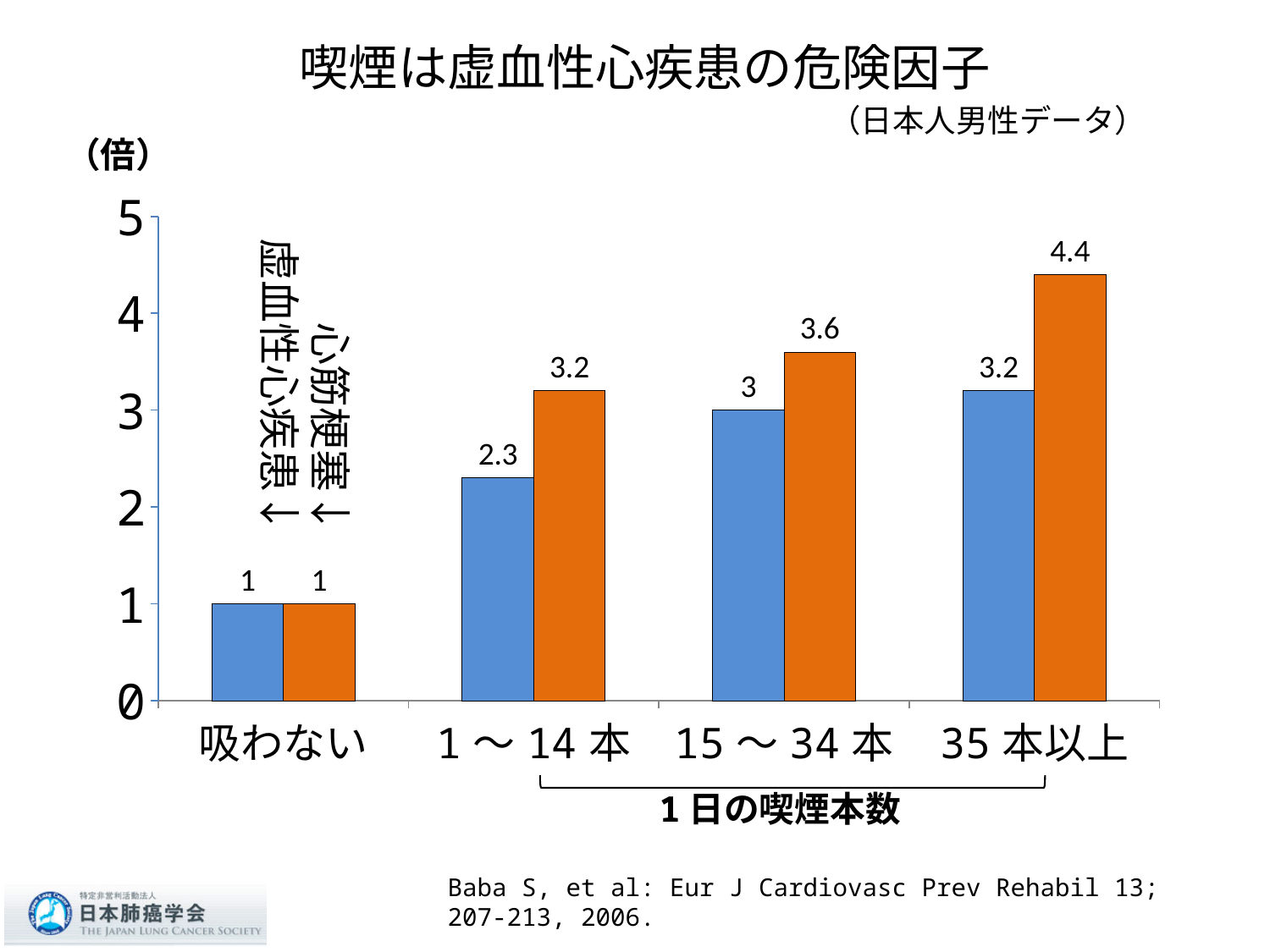
Which is larger in the 15～34本 category: 虚血性心疾患 or 心筋梗塞? 心筋梗塞 What is the value for 心筋梗塞 in the 15～34本 category? 3.6 Which category has the lowest value for 虚血性心疾患? 吸わない What is the value for 心筋梗塞 in the 35本以上 category? 4.4 What is the difference between the 心筋梗塞 and 虚血性心疾患 values in the 35本以上 category? 1.2 Which category has the highest value for 心筋梗塞? 35本以上 What kind of chart is shown on the slide? bar chart How many smoking categories are shown on the x axis? 4 Do the 虚血性心疾患 values rise or fall as the number of cigarettes per day increases? rise What unit is shown at the top of the y axis? （倍） How many data series are plotted in the chart? 2 What is the value for 虚血性心疾患 in the 1～14本 category? 2.3